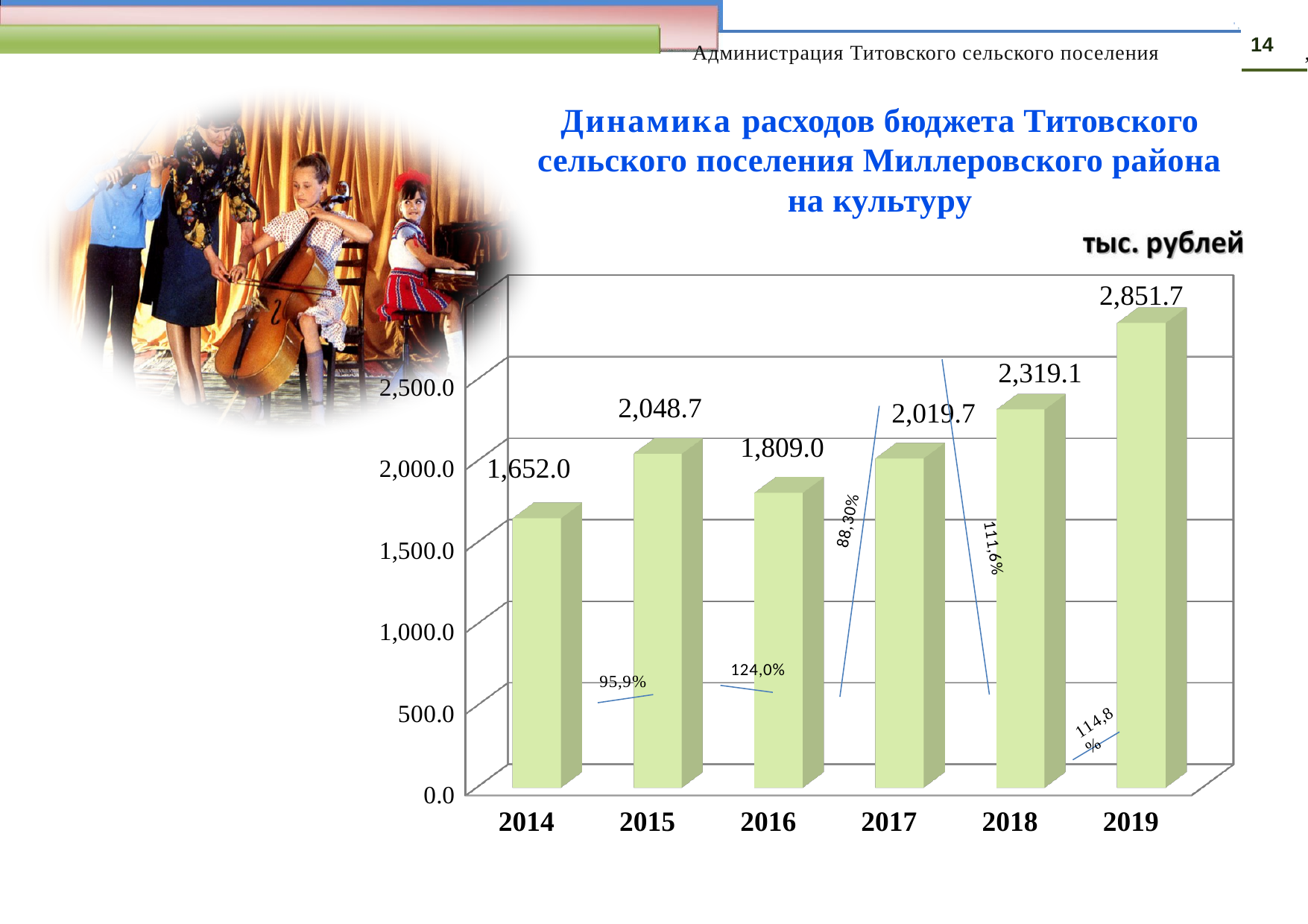
What is the difference between the values for 2015 and 2016? 239.7 What is the value for 2014? 1,652.0 What is the value for 2018? 2,319.1 Which year has the lowest value? 2014 Is the value for 2016 greater or less than 2,000.0? less What unit is stated above the chart? тыс. рублей What is the value for 2016? 1,809.0 Which year has the highest value? 2019 What kind of chart is shown on the slide? bar chart Which is larger, the value for 2015 or the value for 2017? 2015 What is the difference between the values for 2019 and 2018? 532.6 How many years are shown on the x axis? 6